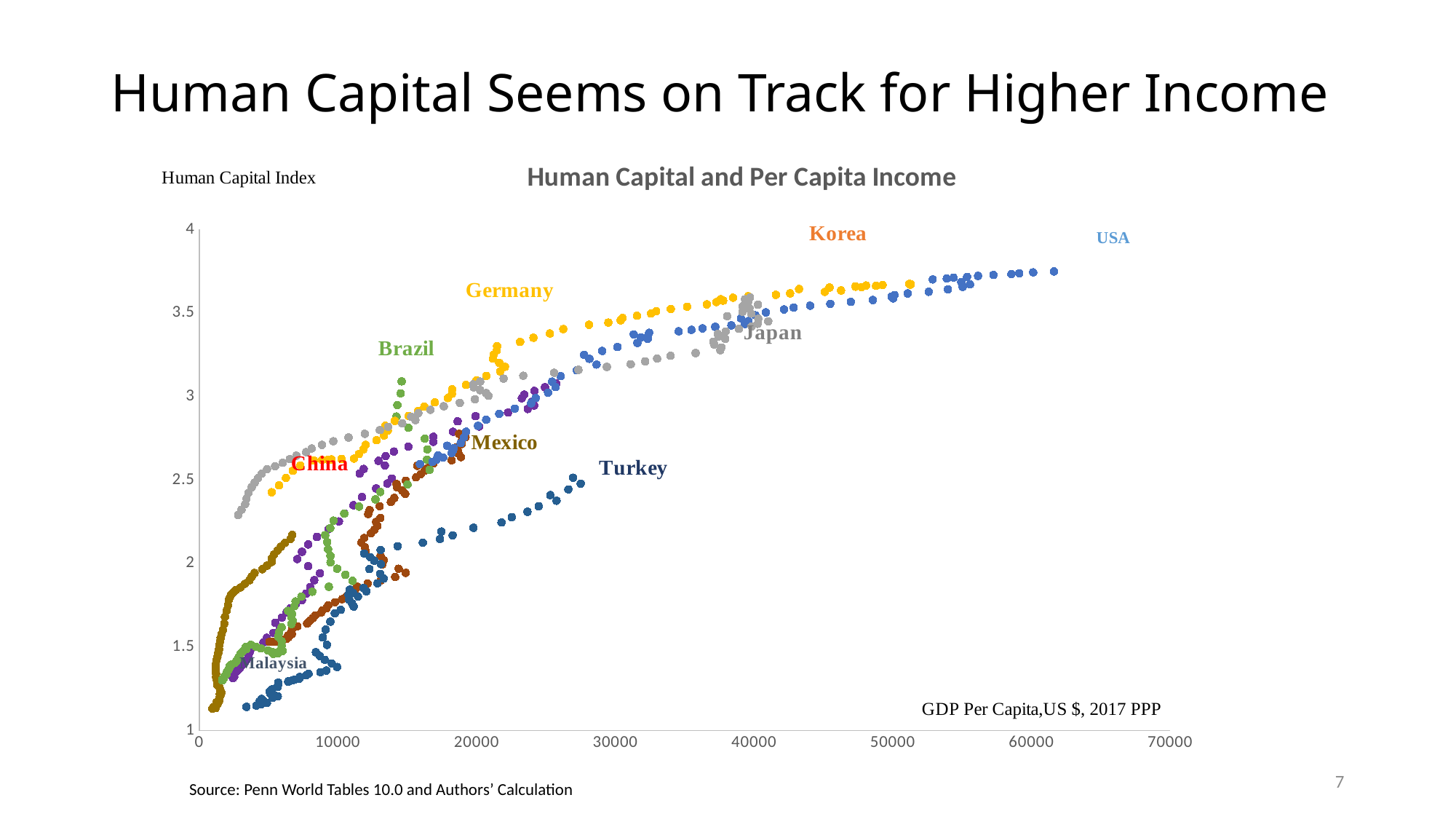
Is the highest GDP per capita reached by the USA series greater or less than 50000? greater Which country's series reaches the highest GDP per capita on the chart? USA Is the highest Human Capital Index reached by the Turkey series greater or less than 3? less Is the highest Human Capital Index reached by the Germany series greater or less than 3.5? greater How many countries are labeled as series on the chart? 9 Which series reaches a higher Human Capital Index, USA or Turkey? USA What is the label of the horizontal axis of the chart? GDP Per Capita,US $, 2017 PPP What is the title of the chart? Human Capital and Per Capita Income Does the Human Capital Index generally rise or fall as GDP per capita increases along the x axis? rise What kind of chart is shown on the slide? Scatter chart